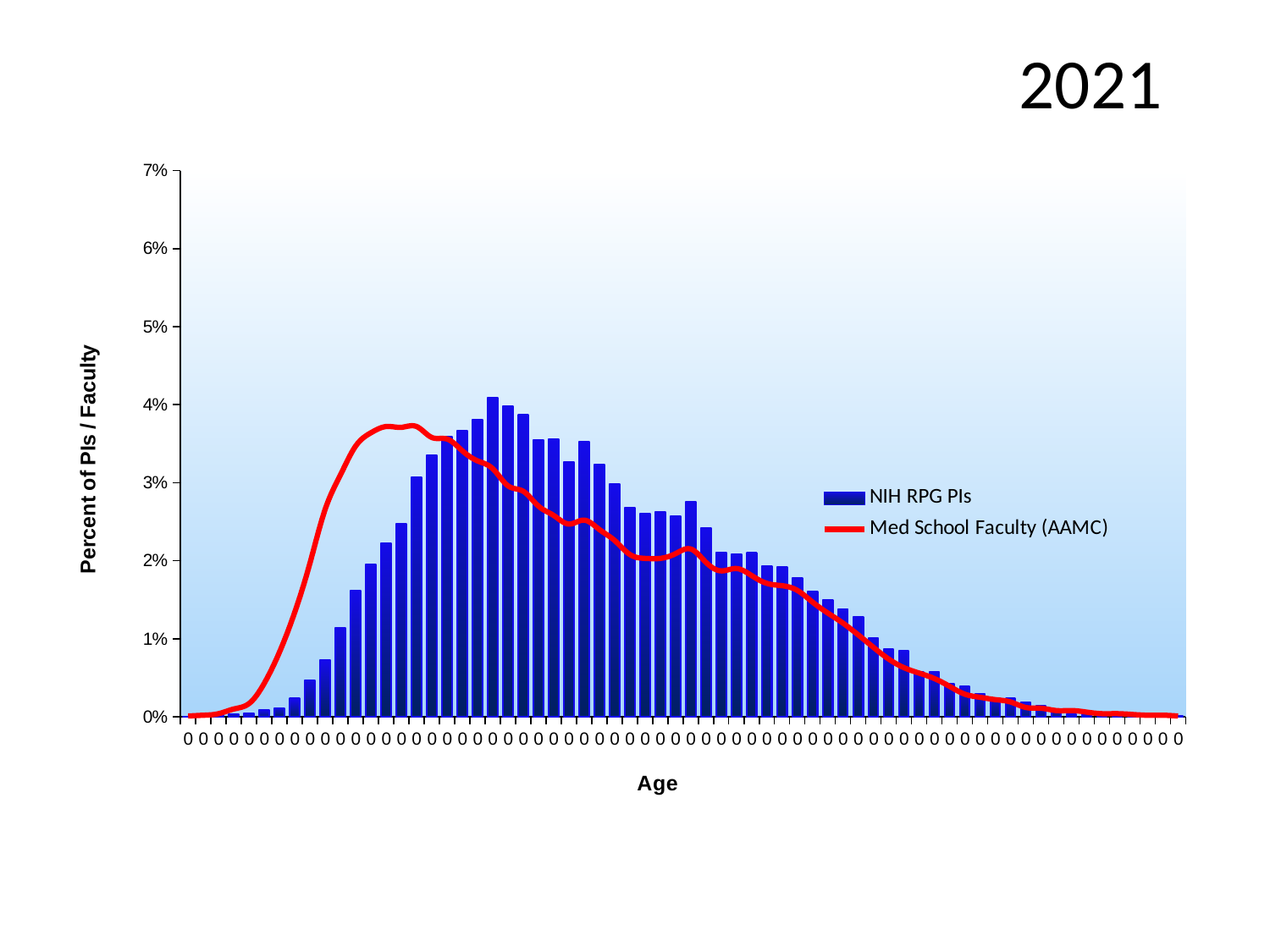
Is the peak of the Med School Faculty (AAMC) line greater or less than 3%? greater Is the value of the Med School Faculty (AAMC) line at the far right end of the Age axis greater or less than 1%? less Is the value of the Med School Faculty (AAMC) line at the far left end of the Age axis greater or less than 1%? less Do the NIH RPG PIs bar values rise or fall toward the right end of the Age axis? fall What kind of chart is shown on the slide? bar chart with a line What are the two series named in the legend? NIH RPG PIs and Med School Faculty (AAMC) Which series reaches a higher peak value, NIH RPG PIs or Med School Faculty (AAMC)? NIH RPG PIs How many series does the legend list? 2 What is the title of the vertical axis? Percent of PIs / Faculty